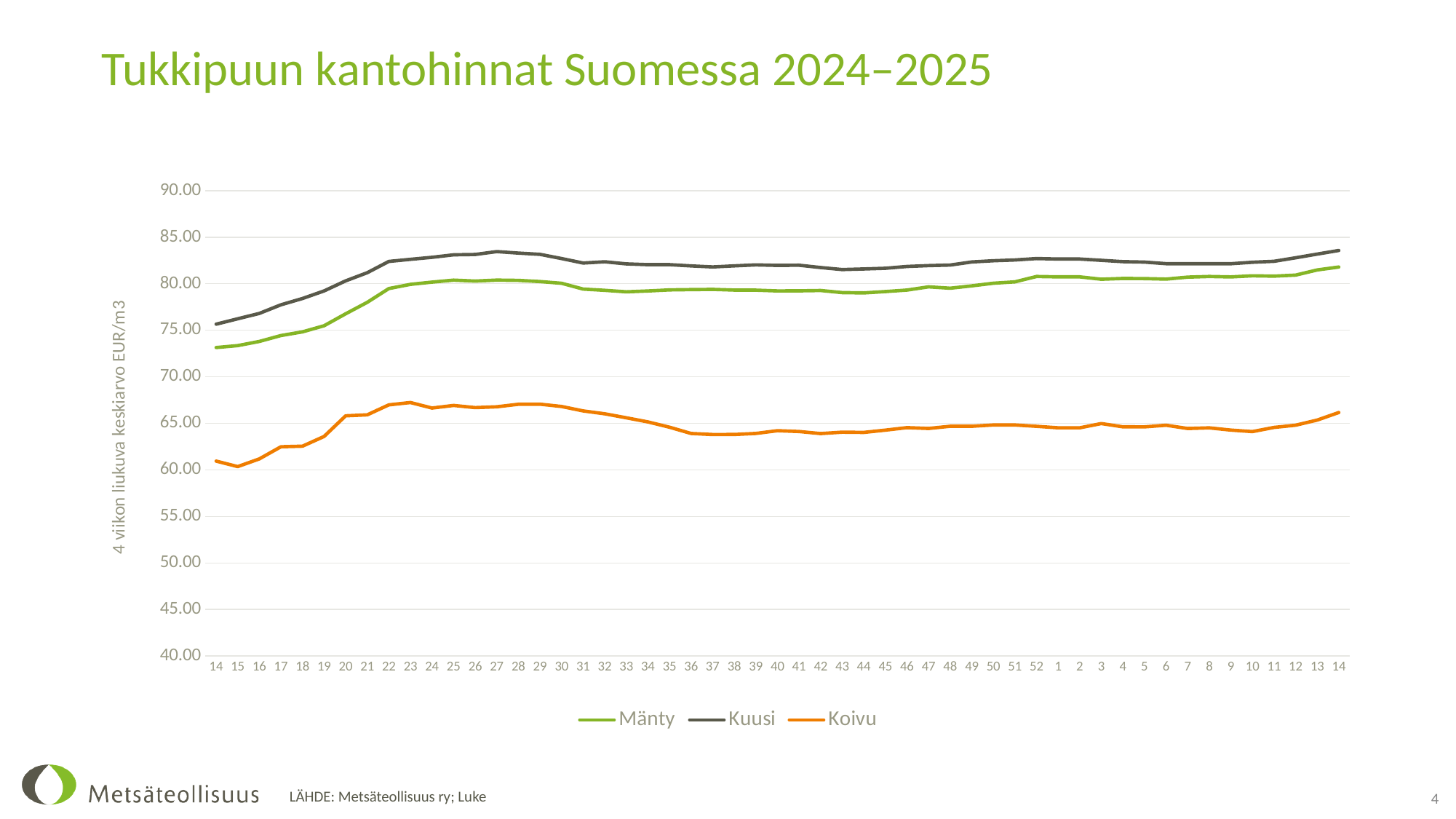
How many series does the legend list? 3 At week 30, which is larger, Kuusi or Mänty? Kuusi Is the value for Koivu at week 15 greater or less than 65? less What kind of chart is shown on the slide? line chart Does the Mänty line rise or fall from week 14 to week 22? rise How many weekly points are plotted along the x axis? 53 Is the value for Mänty at week 14 (the first point) greater or less than 75? less Which series has the highest values throughout the chart? Kuusi Is the value for Kuusi at week 27 greater or less than 80? greater What is the title of the chart on the slide? Tukkipuun kantohinnat Suomessa 2024–2025 Which series has the lowest values throughout the chart? Koivu